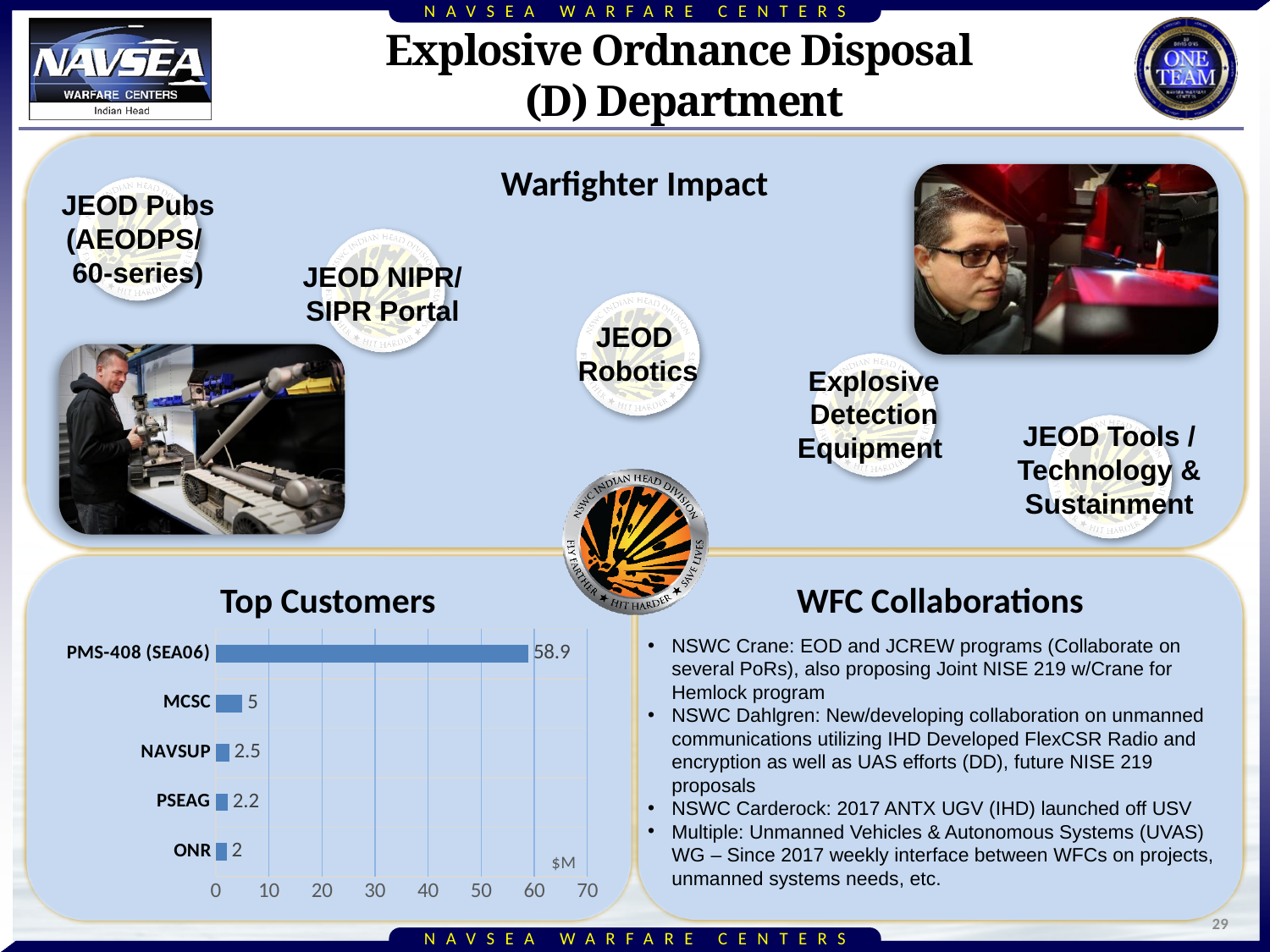
What unit is indicated on the x axis of the Top Customers chart? $M What is the value for MCSC in the Top Customers chart? 5 What kind of chart is the Top Customers chart? bar chart In the Top Customers chart, which is larger, the value for MCSC or the value for NAVSUP? MCSC What is the value for NAVSUP in the Top Customers chart? 2.5 What is the difference between the values for PMS-408 (SEA06) and MCSC in the Top Customers chart? 53.9 Which customer has the lowest value in the Top Customers chart? ONR Which customer has the highest value in the Top Customers chart? PMS-408 (SEA06) What is the value for ONR in the Top Customers chart? 2 How many customers are shown in the Top Customers chart? 5 What is the value for PSEAG in the Top Customers chart? 2.2 What is the value for PMS-408 (SEA06) in the Top Customers chart? 58.9